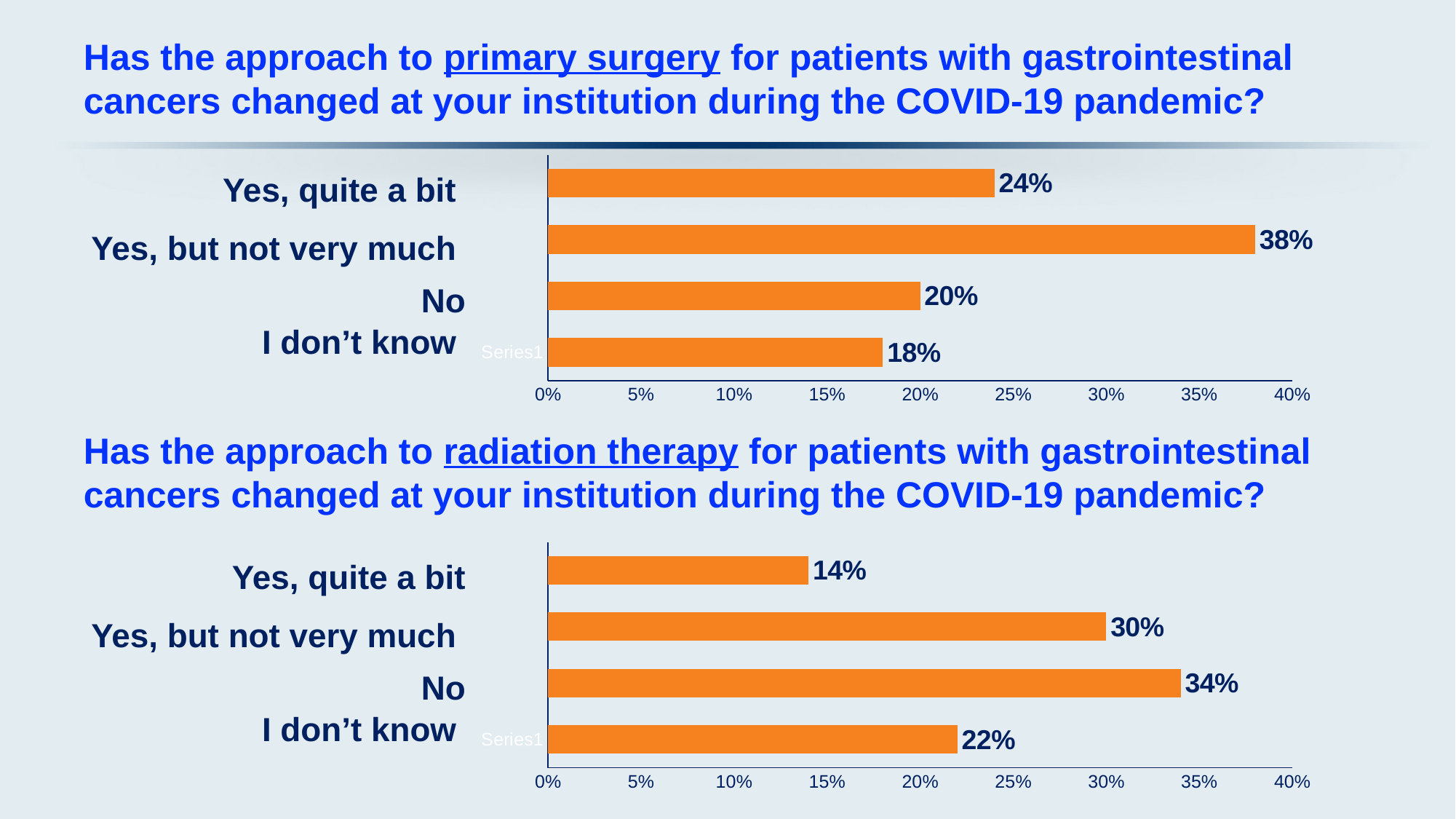
In the primary surgery chart, what is the total of the 'Yes, quite a bit' and 'Yes, but not very much' responses? 62% In the primary surgery chart, what is the difference between 'Yes, but not very much' and 'Yes, quite a bit'? 14% How many response categories does the primary surgery chart show? 4 What is the maximum value shown on the x axis of the radiation therapy chart? 40% What type of chart is used for the radiation therapy question? Bar chart In the primary surgery chart, which response has the highest value? Yes, but not very much In the primary surgery chart, what percentage answered 'Yes, but not very much'? 38% In the radiation therapy chart, which response has the lowest value? Yes, quite a bit In the primary surgery chart, which is larger: 'No' or 'I don't know'? No In the radiation therapy chart, is the value for 'Yes, but not very much' greater or less than 25%? greater In the radiation therapy chart, what percentage answered 'No'? 34% In the radiation therapy chart, what is the difference between 'No' and 'I don't know'? 12%